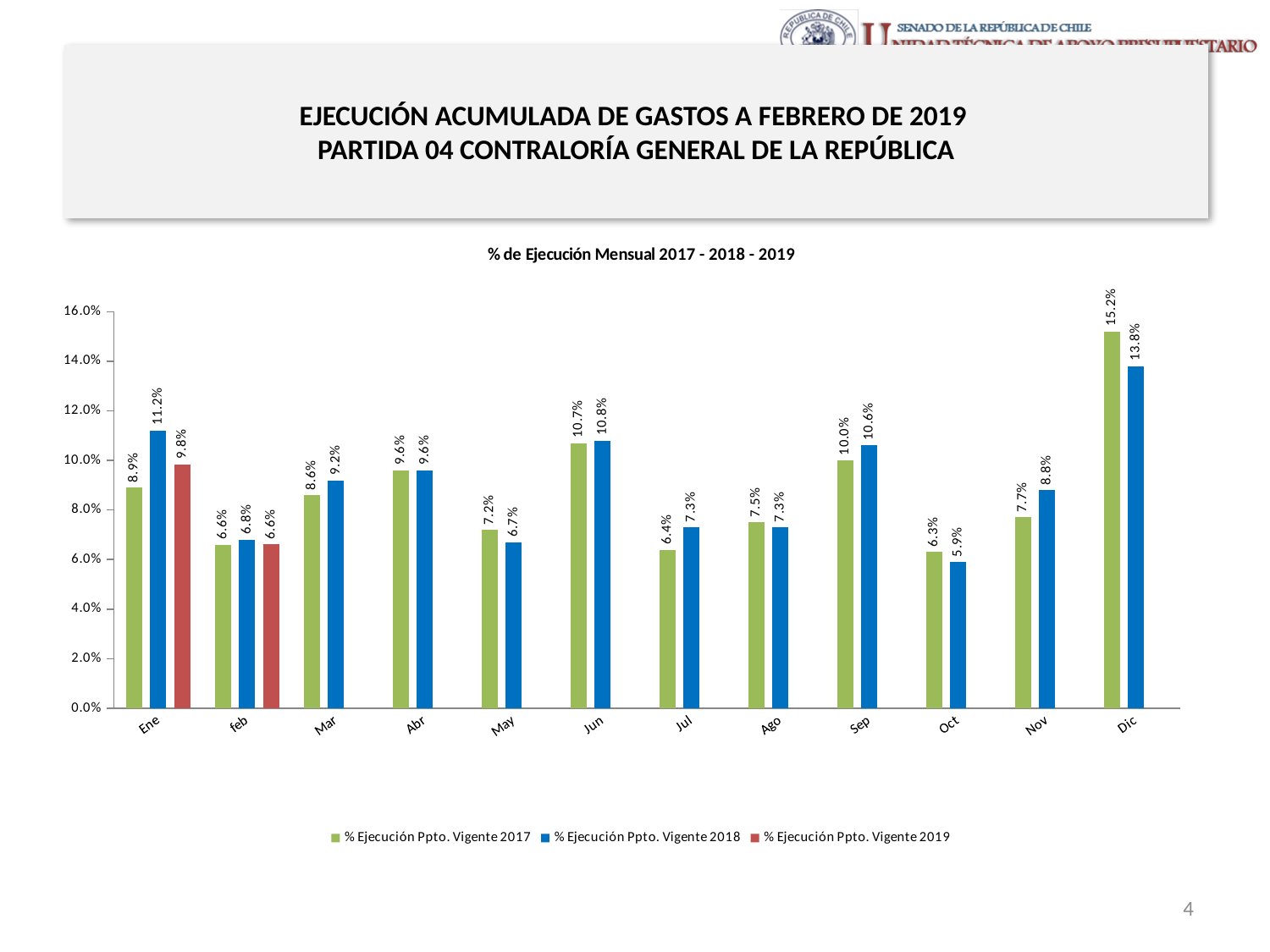
Is the value for % Ejecución Ppto. Vigente 2019 in Ene greater or less than 8.0%? greater Which is larger in Nov: the 2017 value or the 2018 value? 2018 Which month has the highest value for % Ejecución Ppto. Vigente 2018? Dic Which month has the lowest value for % Ejecución Ppto. Vigente 2017? Oct What is the title of the chart? % de Ejecución Mensual 2017 - 2018 - 2019 How many months are shown on the x axis? 12 What is the difference between the 2017 and 2018 values in Ene? 2.3% How many series does the legend list? 3 What is the value for % Ejecución Ppto. Vigente 2019 in feb? 6.6% What is the value for % Ejecución Ppto. Vigente 2018 in Ene? 11.2% What is the value for % Ejecución Ppto. Vigente 2017 in Dic? 15.2% What kind of chart is shown? bar chart